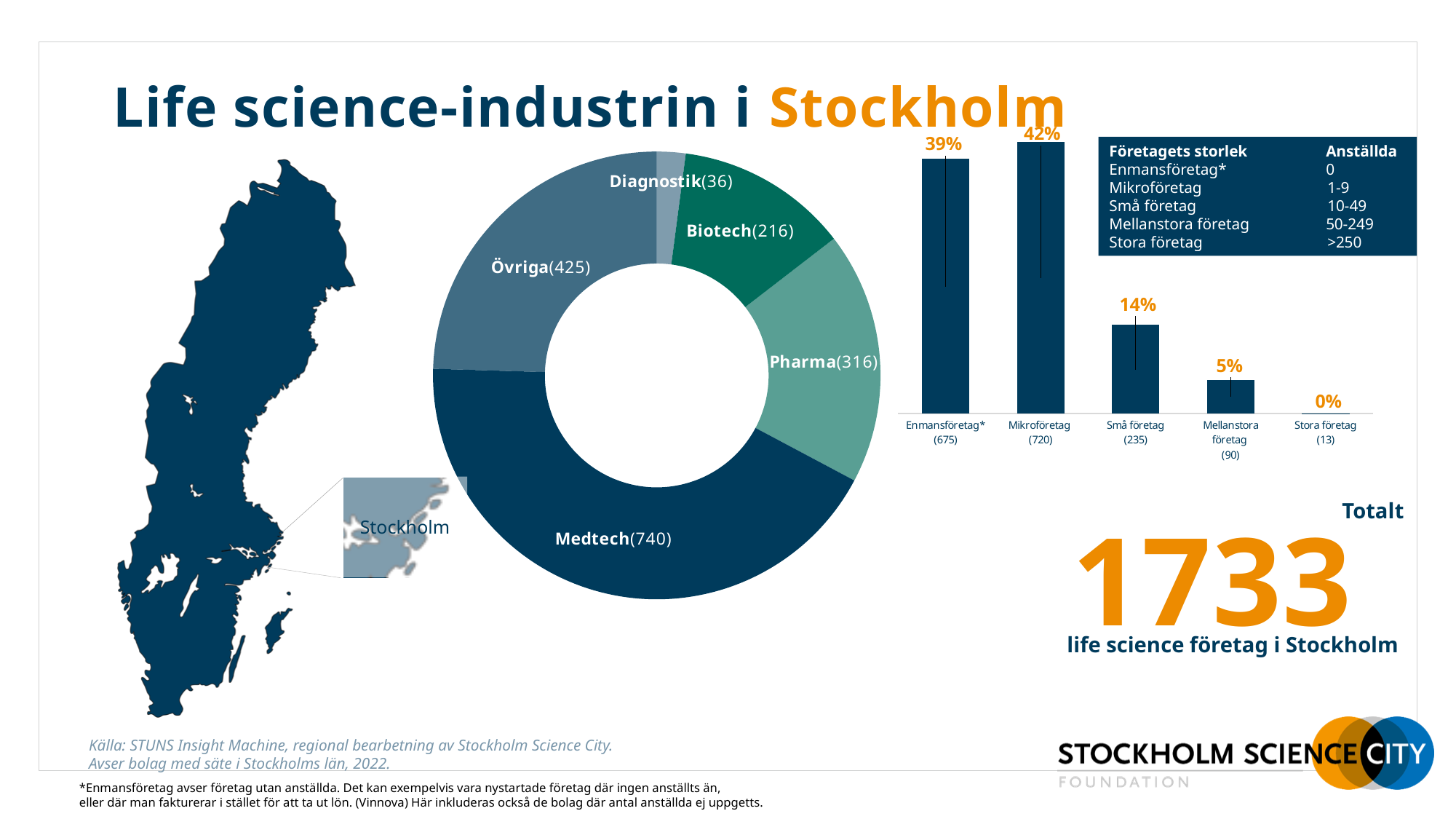
In the donut chart, what is the difference between the Pharma and Biotech values? 100 In the bar chart of company size, what is the difference in percentage points between Enmansföretag* and Små företag? 25 percentage points What kind of chart is the chart showing company sizes (Enmansföretag, Mikroföretag, etc.)? Bar chart In the bar chart of company size, what percentage is shown for Mikroföretag? 42% In the donut chart, how many companies are in the Medtech sector? 740 In the donut chart, which is larger: Övriga or Pharma? Övriga In the donut chart, which sector has the smallest number of companies? Diagnostik What kind of chart is the chart showing sectors such as Medtech and Pharma? Donut (pie) chart In the donut chart, which sector has the largest number of companies? Medtech How many sectors are shown in the donut chart? 5 In the bar chart of company size, which category has the highest percentage? Mikroföretag In the bar chart of company size, how many companies are in the Små företag category? 235